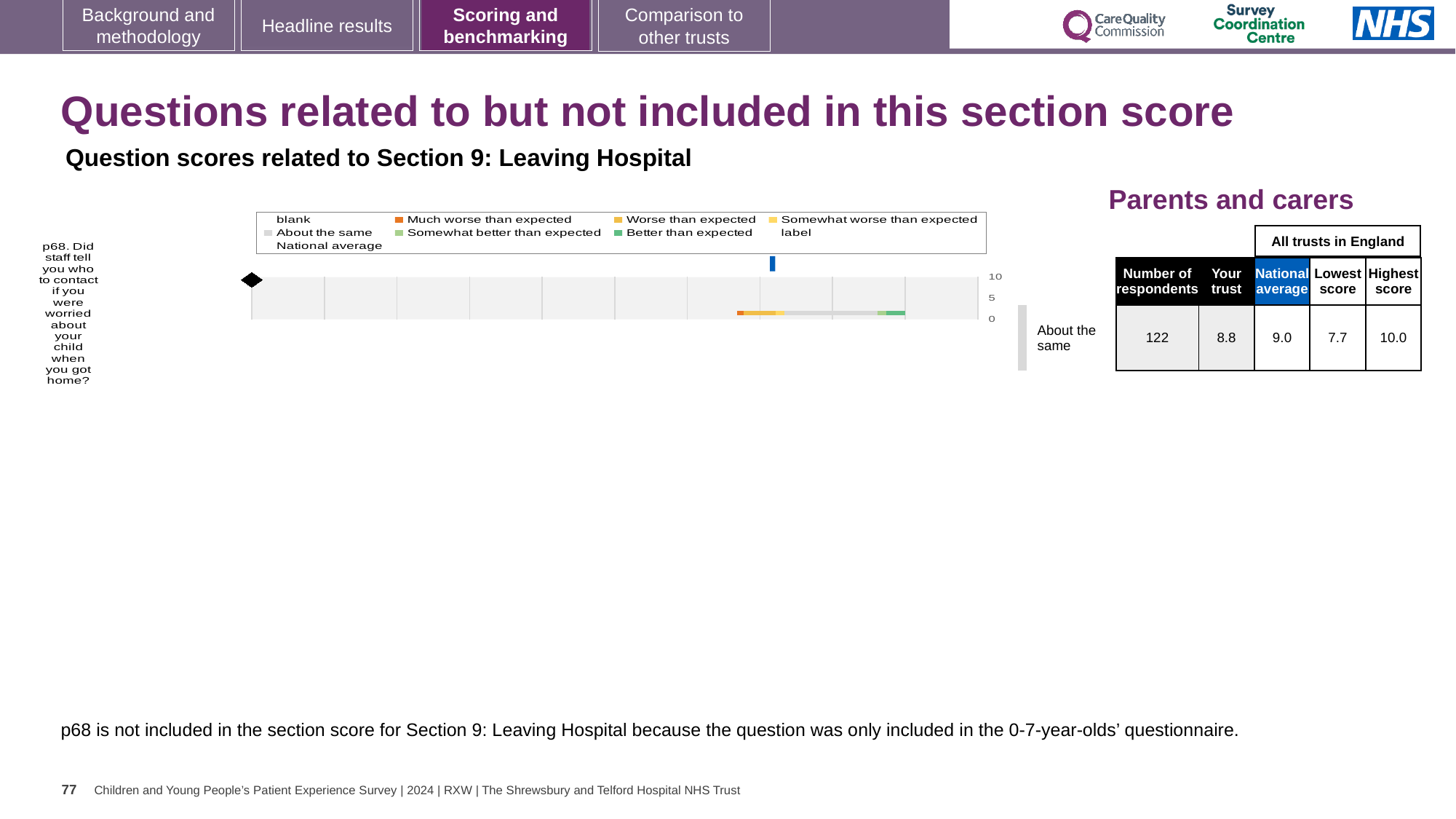
What is the difference between the national average and the 'Your trust' score for question p68? 0.2 How many survey questions are plotted on the chart? 1 What is the difference between the highest and lowest scores for question p68? 2.3 What is the lowest score among all trusts in England for question p68? 7.7 What kind of chart is shown for question p68? Bar chart Which is larger for question p68, the 'Your trust' score or the national average? National average What is the maximum value shown on the chart's score axis? 10 How many respondents answered question p68? 122 What is the 'Your trust' score for question p68? 8.8 What is the national average score for question p68? 9.0 What is the highest score among all trusts in England for question p68? 10.0 Which benchmark category is the trust's result for question p68 placed in? About the same